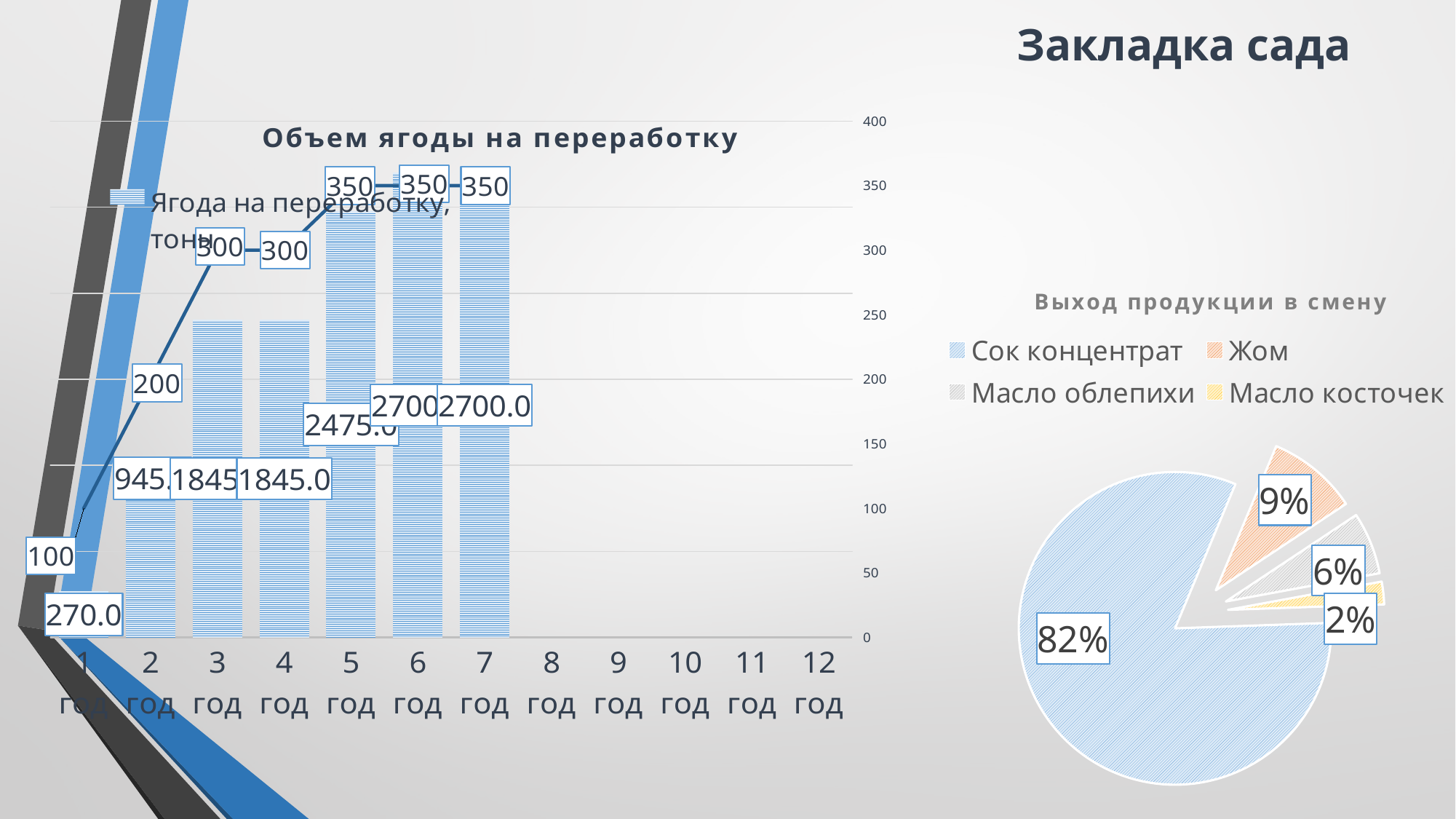
What kind of chart is 'Выход продукции в смену'? pie chart In the chart 'Объем ягоды на переработку', what is the bar value labelled for '1 год'? 270.0 In the pie chart 'Выход продукции в смену', what is the difference between the shares of 'Жом' and 'Масло облепихи'? 3% In the chart 'Объем ягоды на переработку', what is the bar value labelled for '5 год'? 2475.0 In the pie chart 'Выход продукции в смену', what share does 'Жом' have? 9% In the pie chart 'Выход продукции в смену', which category has the smallest slice? Масло косточек In the pie chart 'Выход продукции в смену', how many categories does the legend list? 4 In the pie chart 'Выход продукции в смену', what share does 'Сок концентрат' have? 82% In the chart 'Объем ягоды на переработку', how many year categories are shown on the x axis? 12 In the chart 'Объем ягоды на переработку', does the line 'Ягода на переработку, тонны' rise or fall from '1 год' to '7 год'? rises